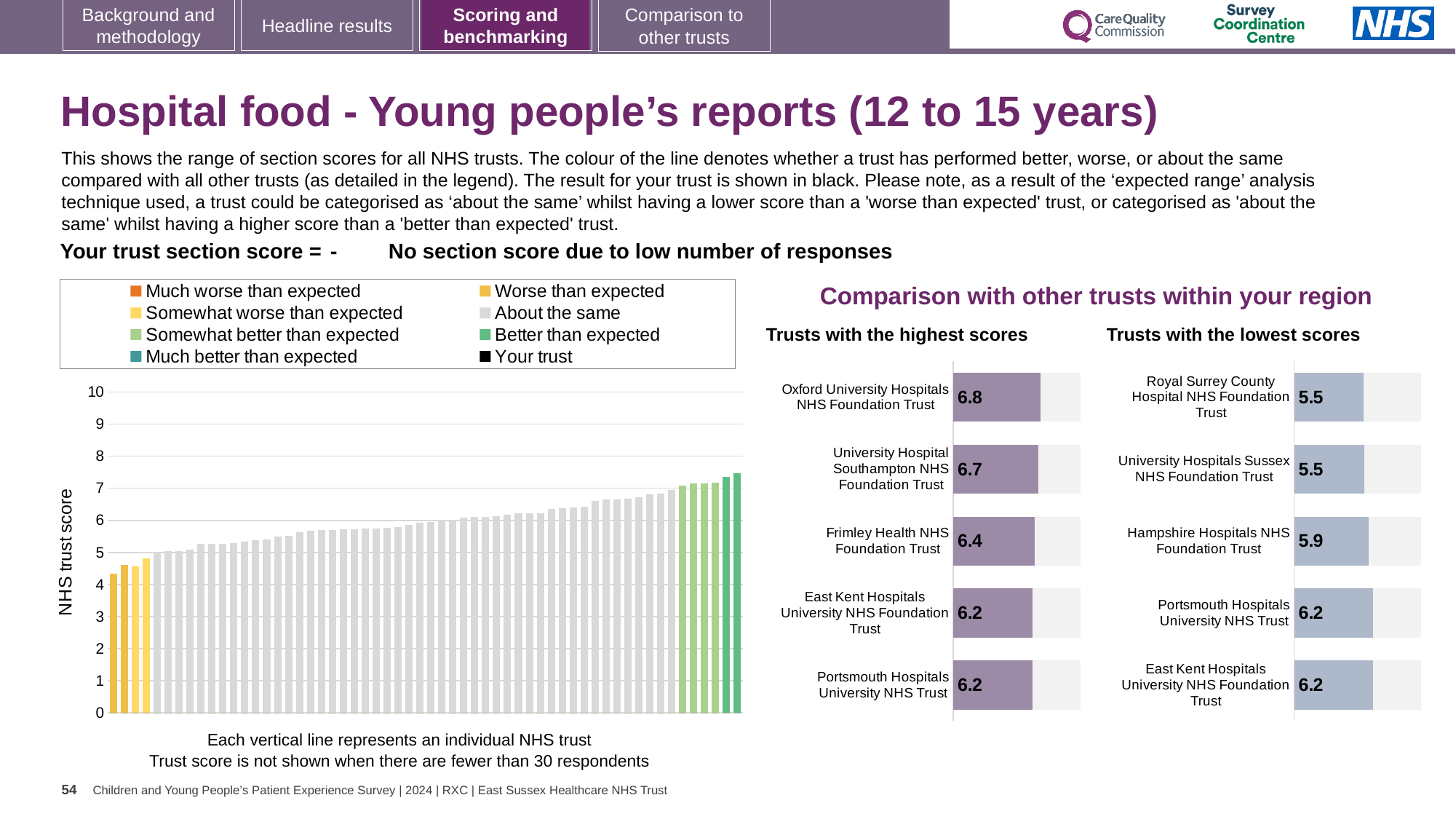
In the 'Trusts with the highest scores' chart, what is the score for Frimley Health NHS Foundation Trust? 6.4 In the 'Trusts with the lowest scores' chart, what is the score for Hampshire Hospitals NHS Foundation Trust? 5.9 How many entries does the legend above the NHS trust score chart list? 8 In the NHS trust score chart on the left, do the bar values rise or fall from left to right? rise In the 'Trusts with the highest scores' chart, which has the larger score: University Hospital Southampton NHS Foundation Trust or East Kent Hospitals University NHS Foundation Trust? University Hospital Southampton NHS Foundation Trust In the 'Trusts with the highest scores' chart, what is the difference between the scores of Oxford University Hospitals NHS Foundation Trust and Frimley Health NHS Foundation Trust? 0.4 In the 'Trusts with the highest scores' chart, what is the score for Oxford University Hospitals NHS Foundation Trust? 6.8 In the 'Trusts with the lowest scores' chart, what is the difference between the scores of Portsmouth Hospitals University NHS Trust and University Hospitals Sussex NHS Foundation Trust? 0.7 In the 'Trusts with the highest scores' chart, which trust has the highest score? Oxford University Hospitals NHS Foundation Trust In the 'Trusts with the lowest scores' chart, what is the score for Royal Surrey County Hospital NHS Foundation Trust? 5.5 In the NHS trust score chart on the left, is the value of the tallest bar greater or less than 7? greater How many trusts are listed in the 'Trusts with the lowest scores' chart? 5